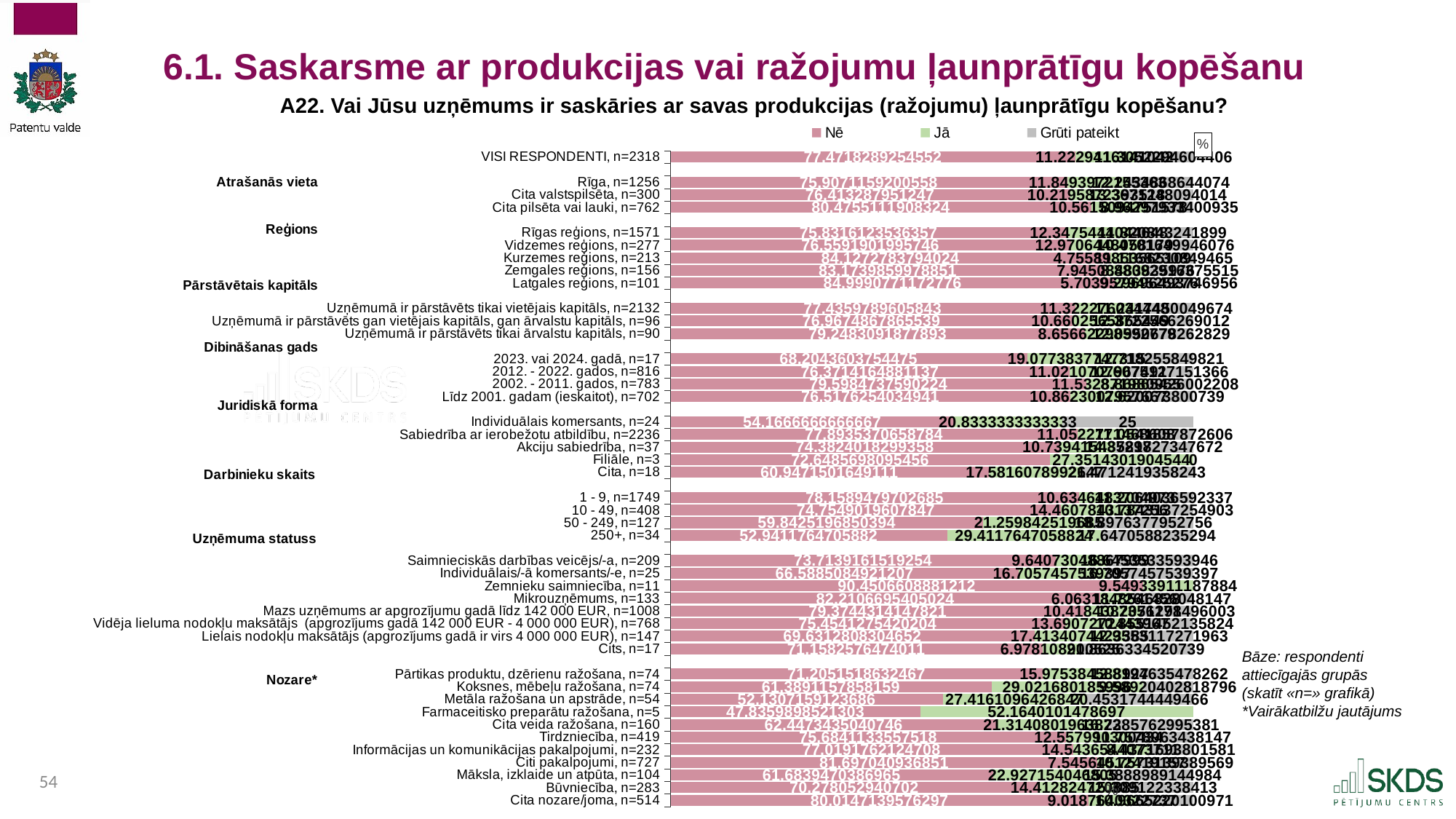
How many categories are listed under the Nozare* group? 11 What are the three legend entries of the chart? Nē, Jā, Grūti pateikt Which category has the lowest Nē value? Farmaceitisko preparātu ražošana, n=5 For Farmaceitisko preparātu ražošana, n=5, which is larger: the Nē value or the Jā value? Jā Is the Nē value for Zemnieku saimniecība, n=11 greater or less than 80? greater Which category has the highest Nē value? Zemnieku saimniecība, n=11 Which has a larger Nē value: Rīga, n=1256 or Cita pilsēta vai lauki, n=762? Cita pilsēta vai lauki, n=762 What is the Jā value for Farmaceitisko preparātu ražošana, n=5? 52.1640101478697 How many series does the legend list? 3 What is the Grūti pateikt value for Individuālais komersants, n=24? 25 What kind of chart is shown on the slide? Stacked bar chart What is the Nē value for VISI RESPONDENTI, n=2318? 77.4718289254552